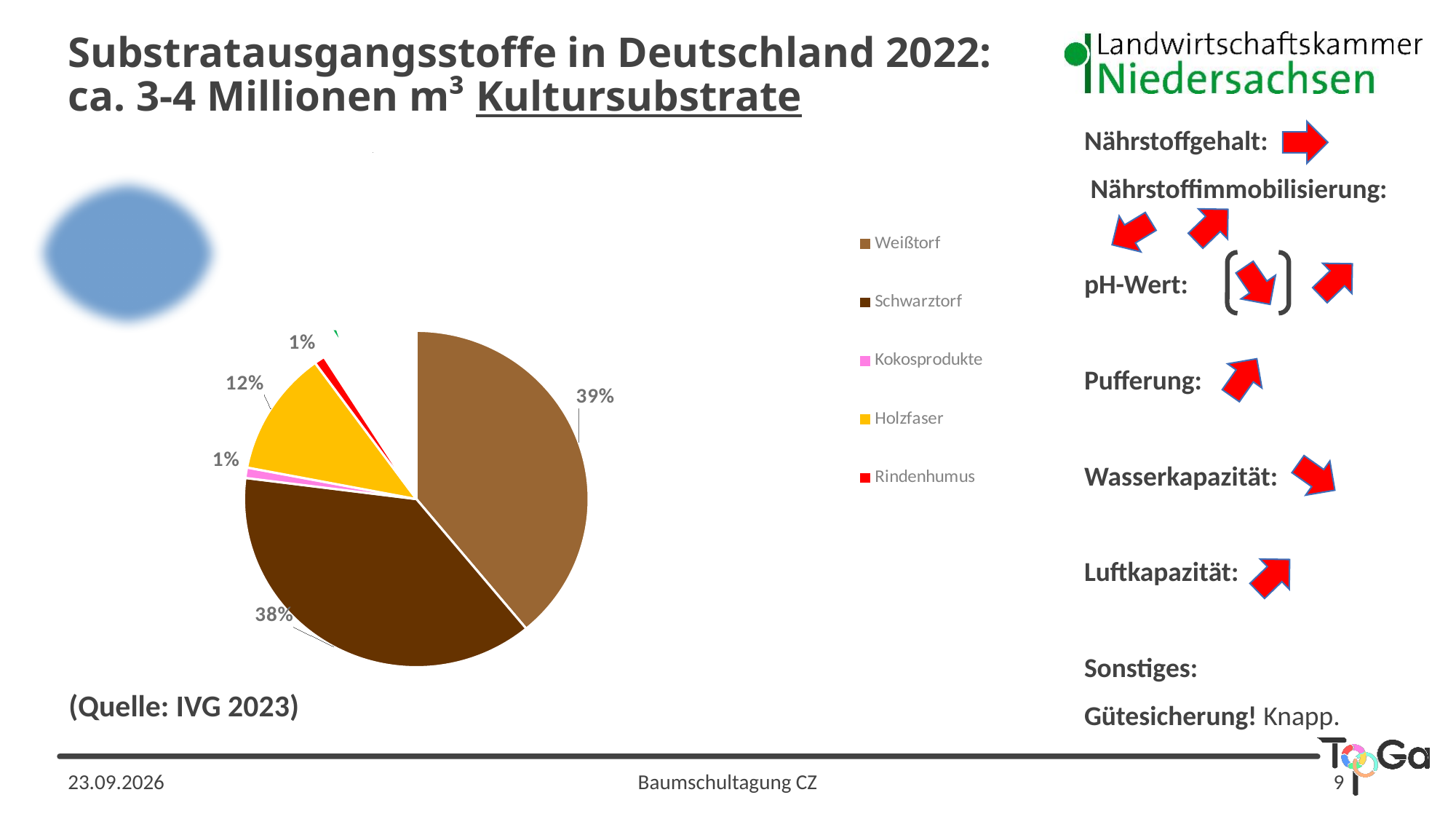
What colour is used for Holzfaser in the pie chart? yellow What percentage does the pie chart show for Kokosprodukte? 1% Which slice is larger, Schwarztorf or Holzfaser? Schwarztorf Which category has the largest slice in the pie chart? Weißtorf How many entries does the legend of the pie chart list? 5 What percentage does the pie chart show for Holzfaser? 12% What kind of chart is shown on the slide? pie chart What percentage does the pie chart show for Schwarztorf? 38% What percentage does the pie chart show for Rindenhumus? 1% What share of the pie chart is labelled for Weißtorf? 39% What is the combined share of Weißtorf and Schwarztorf in the pie chart? 77% What is the difference in percentage points between the Weißtorf slice and the Holzfaser slice? 27%